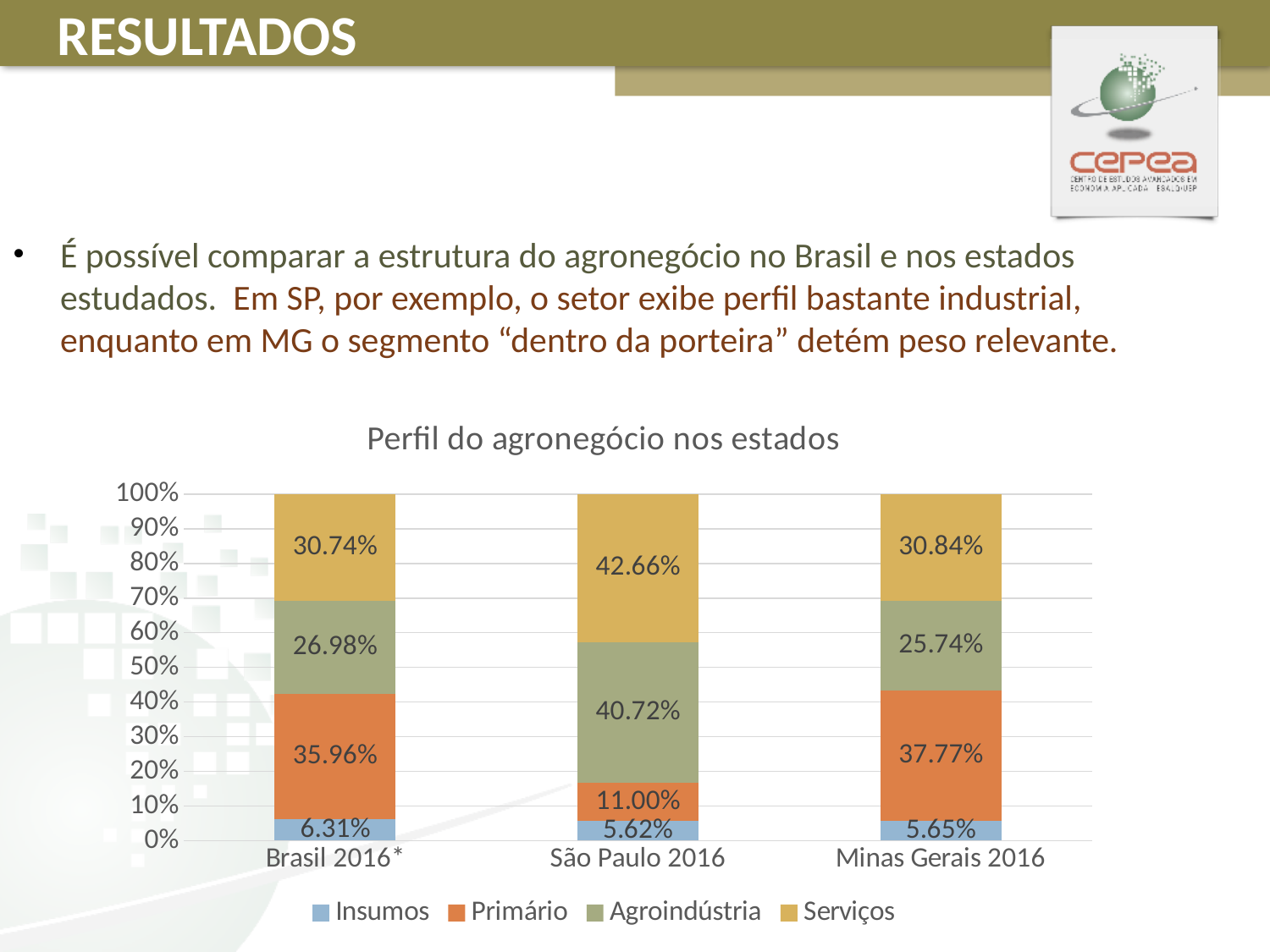
What kind of chart is shown on the slide? Stacked bar chart How many categories are shown on the x axis? 3 Which category has the lowest Primário value? São Paulo 2016 What is the difference between the Serviços values for São Paulo 2016 and Minas Gerais 2016? 11.82% Which category has the highest Agroindústria value? São Paulo 2016 What is the title of the chart? Perfil do agronegócio nos estados What is the value of Primário for São Paulo 2016? 11.00% Which is larger, the Primário value for Brasil 2016* or for Minas Gerais 2016? Minas Gerais 2016 What is the value of Insumos for São Paulo 2016? 5.62% What is the value of Serviços for Brasil 2016*? 30.74% What is the value of Agroindústria for Minas Gerais 2016? 25.74% How many series does the legend list? 4